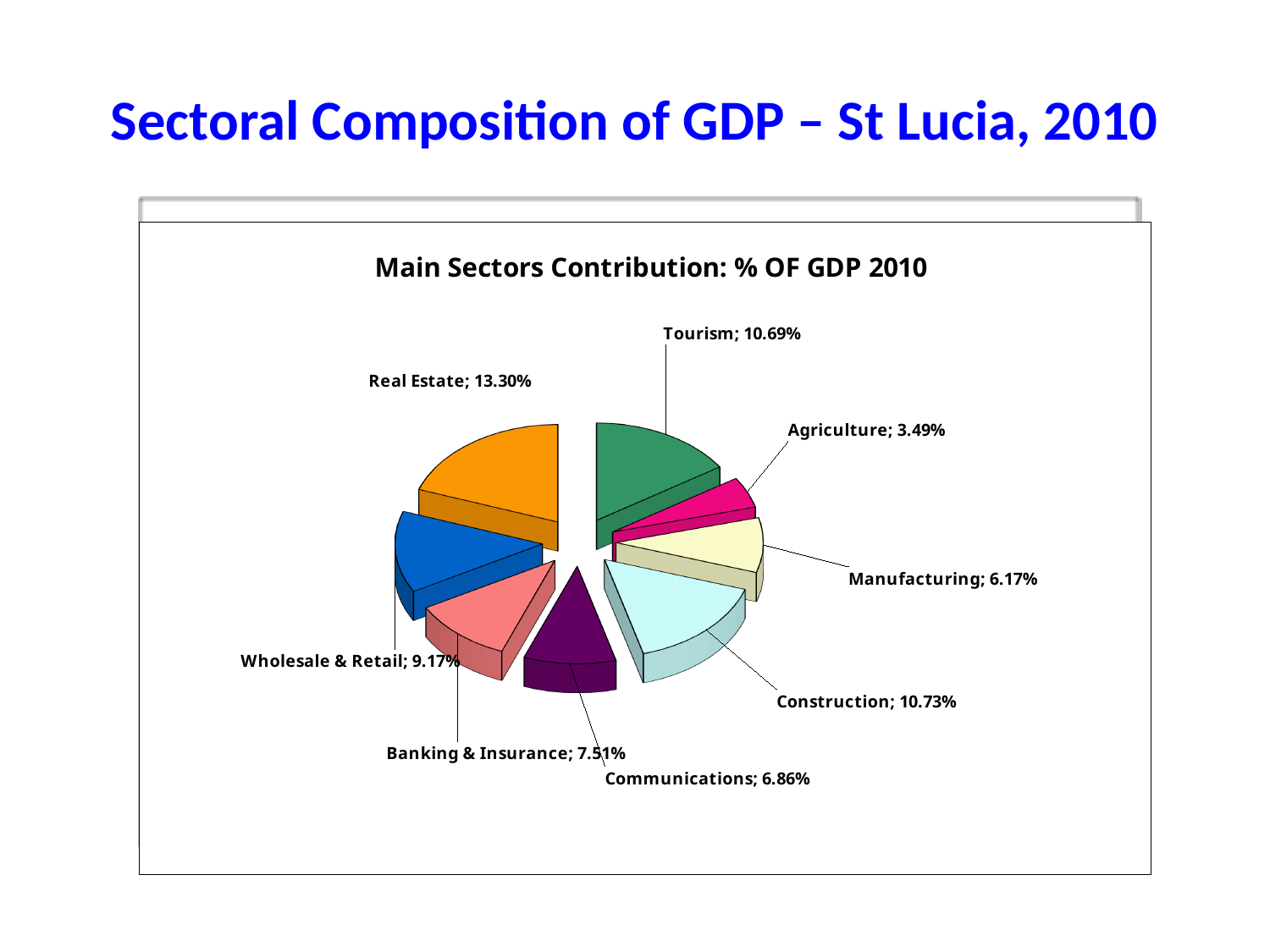
What kind of chart is shown on the slide? Pie chart What percentage is labelled for Banking & Insurance? 7.51% What value does the chart show for Communications? 6.86% What is the difference between the Construction and Manufacturing values? 4.56% How many sectors are shown in the pie chart? 8 What percentage of GDP does Tourism contribute according to the pie chart? 10.69% Which sector has the largest slice in the pie chart? Real Estate What is the value shown for Real Estate in the pie chart? 13.30% Which is larger, the value for Wholesale & Retail or the value for Manufacturing? Wholesale & Retail What is the title of the chart? Main Sectors Contribution: % OF GDP 2010 What is the difference between the Real Estate and Agriculture values? 9.81% Which sector has the smallest slice in the pie chart? Agriculture